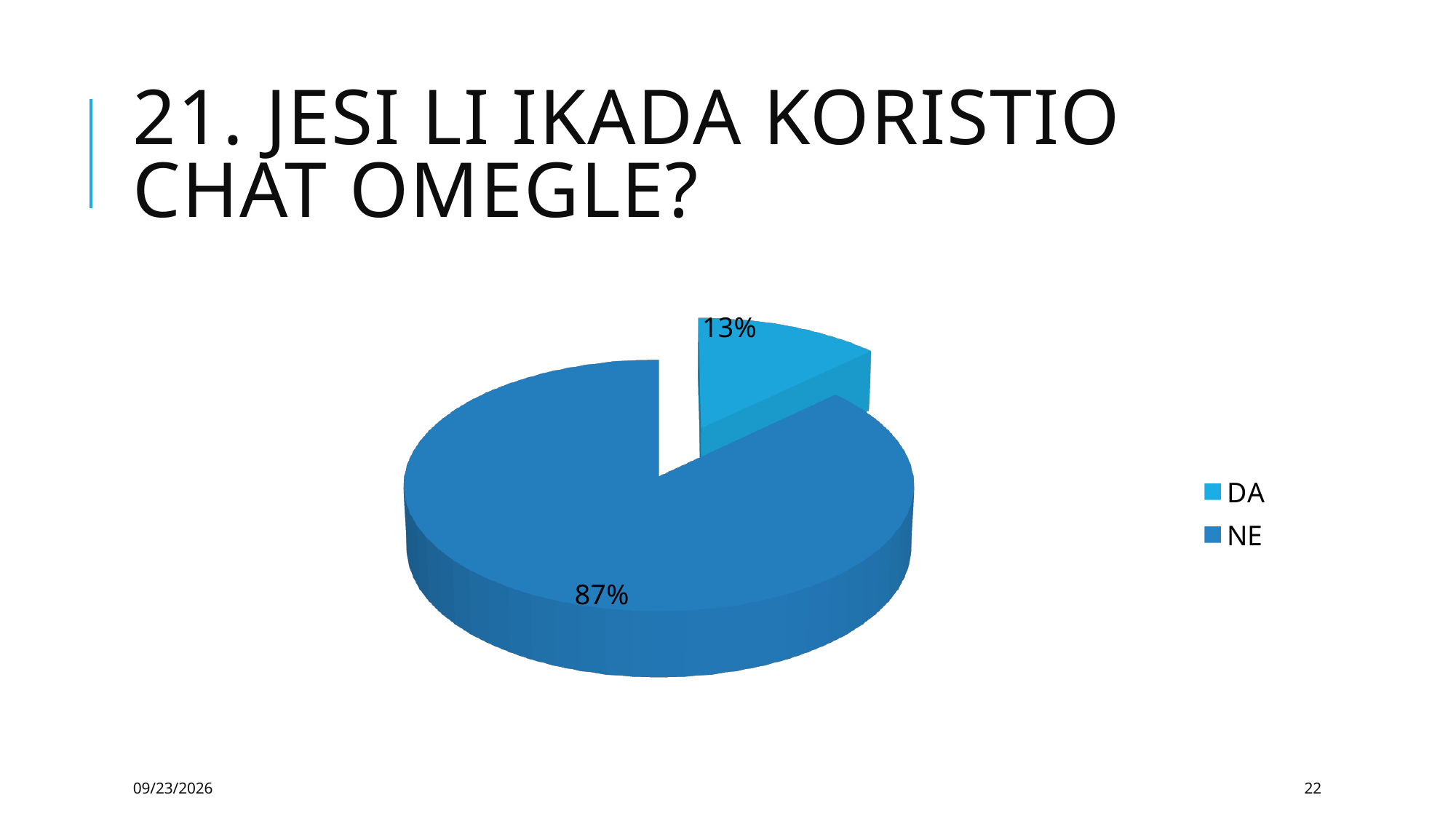
What kind of chart is shown on the slide? pie chart How many slices does the pie chart have? 2 Which category has the smallest share of the pie? DA What percentage of the pie is labelled NE? 87% What is the difference in percentage points between the NE and DA slices? 74 Which slice is larger, DA or NE? NE What percentage of the pie is labelled DA? 13% What is the title of the slide containing the chart? 21. JESI LI IKADA KORISTIO CHAT OMEGLE? Which slice is pulled out from the rest of the pie? DA Which category has the largest share of the pie? NE What is the share of the pie taken by the DA slice? 13% How many entries does the legend list? 2